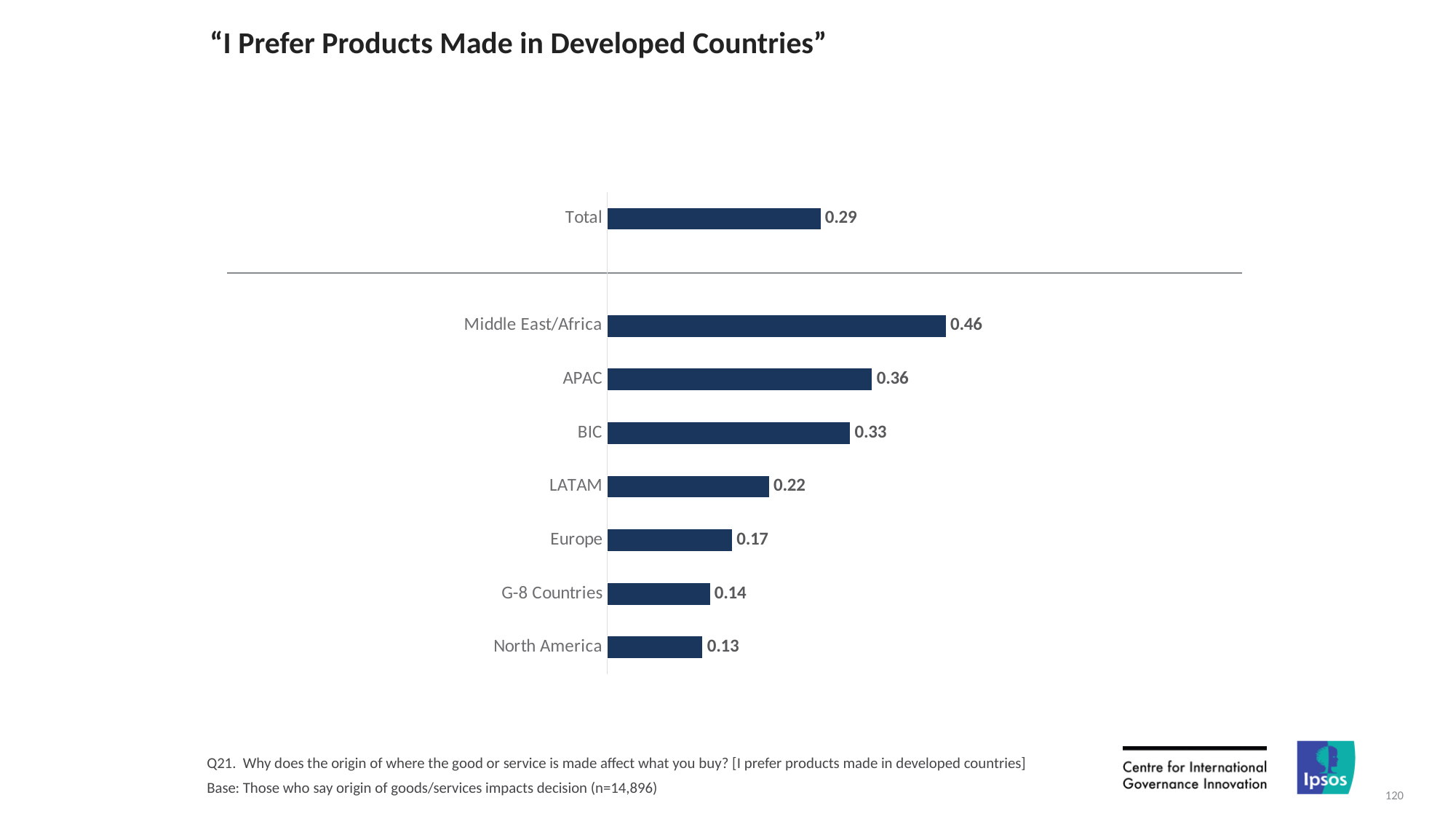
What kind of chart is shown on the slide? Bar chart Which category has the lowest value? North America What is the title of the chart? "I Prefer Products Made in Developed Countries" Which is larger, the value for LATAM or the value for Europe? LATAM What is the difference between the values for APAC and BIC? 0.03 What is the value for Middle East/Africa? 0.46 What is the value for Europe? 0.17 What is the value for Total? 0.29 What is the difference between the values for Middle East/Africa and LATAM? 0.24 What is the value for North America? 0.13 How many bars are shown in the chart? 8 Which region has the highest value? Middle East/Africa